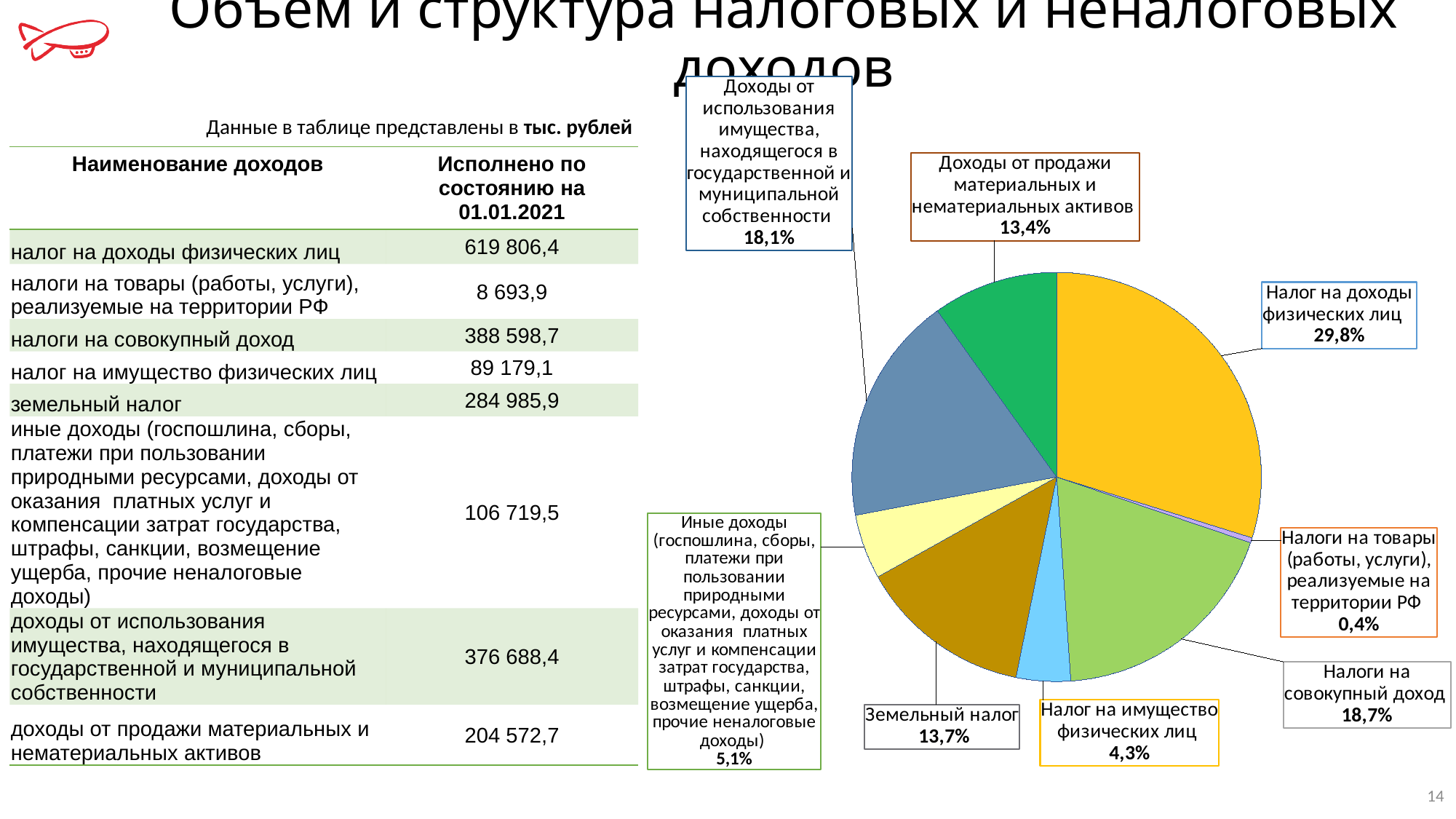
What share of the pie chart is labelled for Налог на доходы физических лиц? 29,8% What share of the pie chart is labelled for Налог на имущество физических лиц? 4,3% What share of the pie chart is labelled for Земельный налог? 13,7% What kind of chart is shown on the slide? pie chart By how many percentage points does the share of Налог на доходы физических лиц exceed the share of Налоги на совокупный доход? 11,1 Which slice is larger: Земельный налог or Иные доходы? Земельный налог Which category has the smallest slice in the pie chart? Налоги на товары (работы, услуги), реализуемые на территории РФ Which slice is larger: Налоги на совокупный доход or Доходы от использования имущества, находящегося в государственной и муниципальной собственности? Налоги на совокупный доход Which category has the largest slice in the pie chart? Налог на доходы физических лиц What share of the pie chart is labelled for Доходы от продажи материальных и нематериальных активов? 13,4% What colour is the slice for Налог на доходы физических лиц in the pie chart? yellow How many slices does the pie chart have? 8